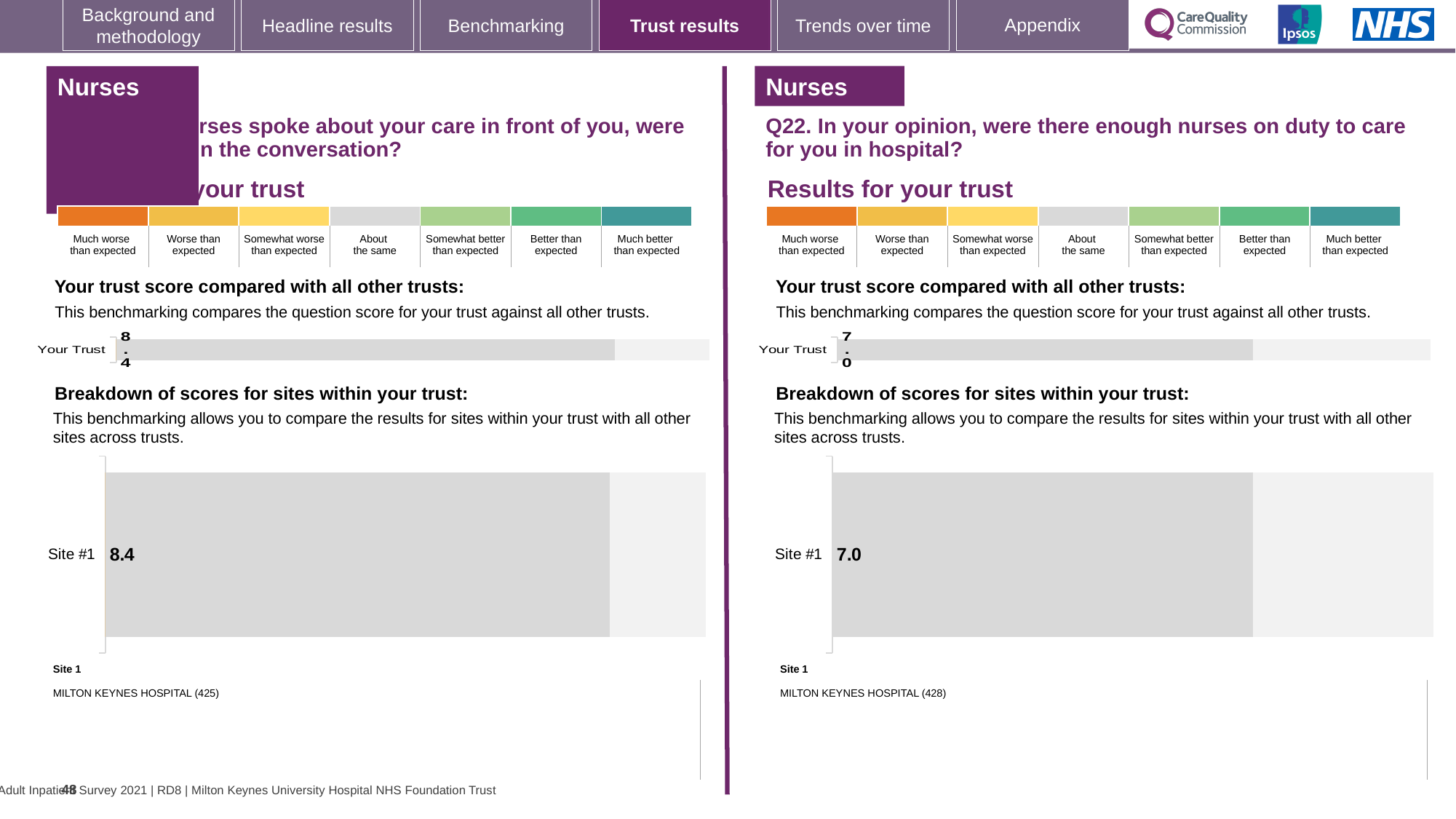
Which is larger: the Site #1 score on the left-hand side of the slide or the Site #1 score on the right-hand side (Q22)? Left-hand side (8.4) Which hospital is listed as Site 1 on the left-hand side of the slide? MILTON KEYNES HOSPITAL (425) How many sites are shown in the site breakdown chart on the left-hand side of the slide? 1 On the right-hand side of the slide (Q22), what is the score shown for Your Trust in the trust comparison chart? 7.0 What kind of chart is used to show the Site #1 score on the right-hand side of the slide (Q22)? Bar chart What is the difference between the Site #1 score on the left-hand side of the slide and the Site #1 score on the right-hand side (Q22)? 1.4 How many sites are shown in the site breakdown chart on the right-hand side of the slide (Q22)? 1 Which hospital is listed as Site 1 on the right-hand side of the slide (Q22)? MILTON KEYNES HOSPITAL (428) On the right-hand side of the slide (Q22), is the Site #1 score the same as the Your Trust score? Yes, both are 7.0 On the right-hand side of the slide (Q22), what is the score shown for Site #1? 7.0 On the left-hand side of the slide, what is the score shown for Your Trust in the trust comparison chart? 8.4 On the left-hand side of the slide, what is the score shown for Site #1? 8.4